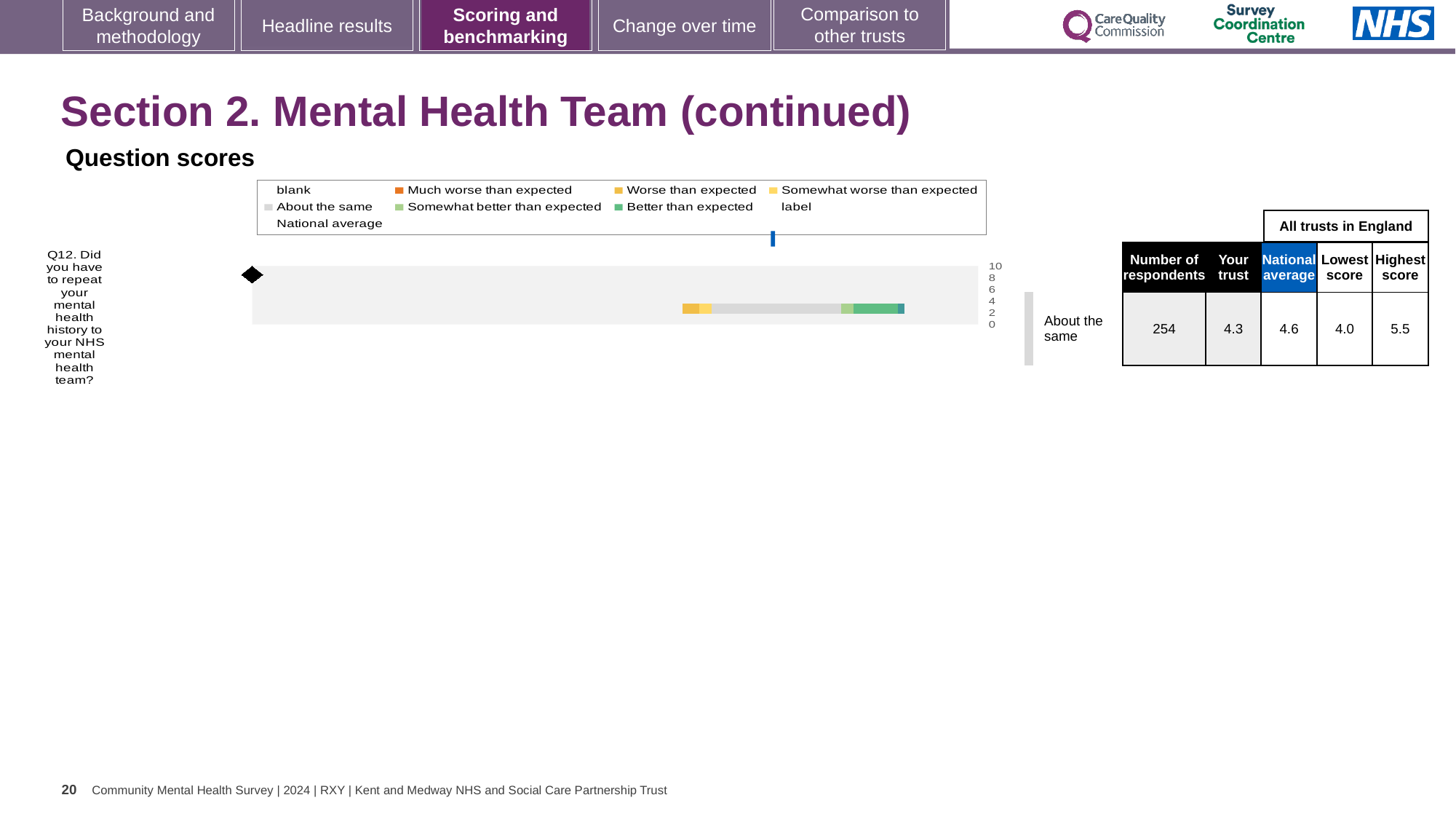
What is the 'Your trust' score for Q12? 4.3 What is the national average score for Q12? 4.6 What kind of chart is used to show the question scores on this slide? bar chart Which is larger for Q12, the 'Your trust' score or the national average? National average Which question is plotted in the question scores chart? Q12. Did you have to repeat your mental health history to your NHS mental health team? What is the lowest score among all trusts in England for Q12? 4.0 What is the difference between the highest and lowest scores among all trusts in England for Q12? 1.5 How many survey questions are plotted in the question scores chart? 1 What benchmark category is shown for Q12 next to the chart? About the same How many respondents answered Q12? 254 What is the difference between the national average and the 'Your trust' score for Q12? 0.3 What is the highest score among all trusts in England for Q12? 5.5